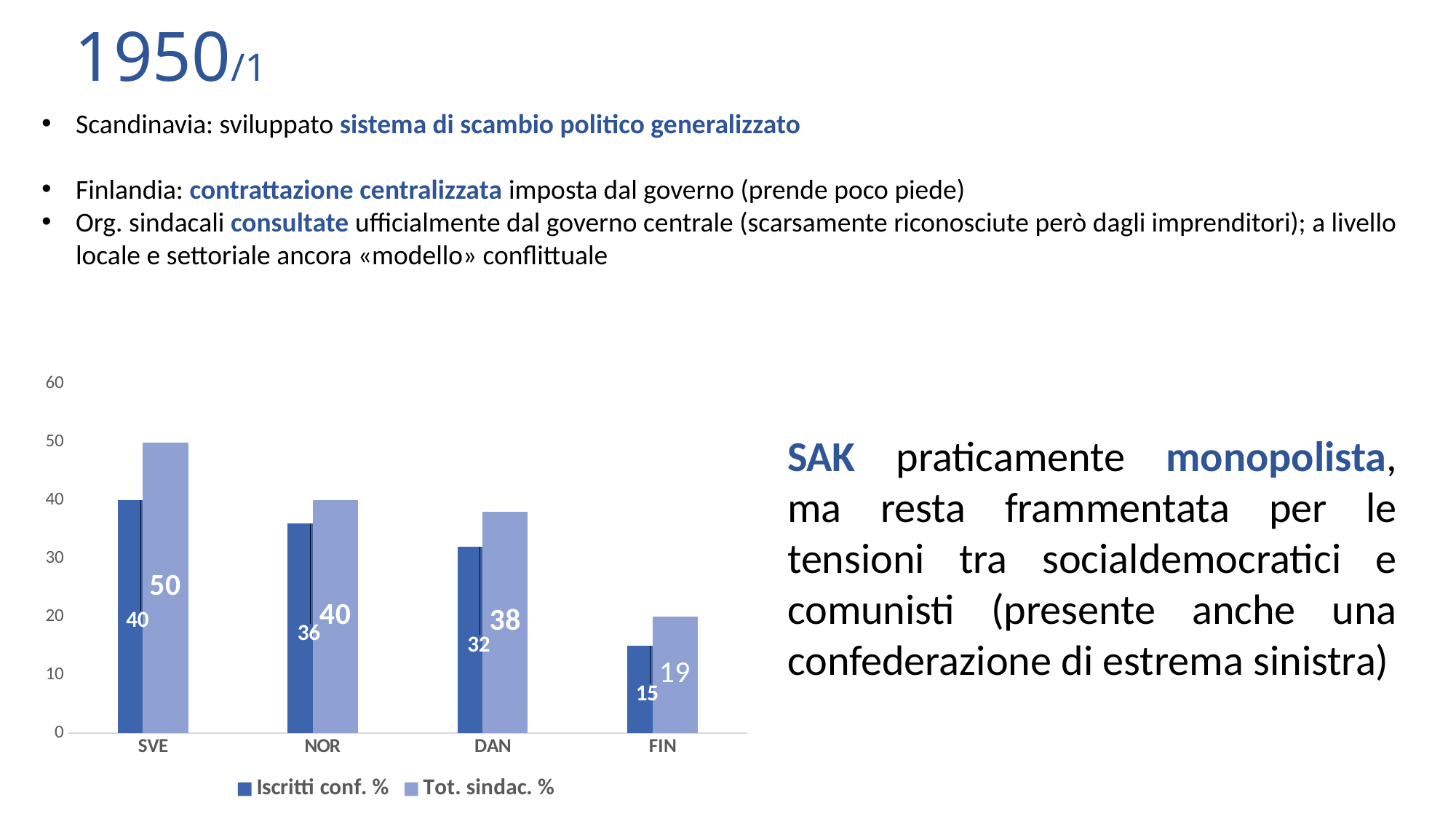
Which category has the lowest Iscritti conf. % value? FIN Which category has the highest Tot. sindac. % value? SVE What is the value of Tot. sindac. % for NOR? 40 How many series does the chart legend list? 2 What is the value of Tot. sindac. % for DAN? 38 Do the Tot. sindac. % values rise or fall from SVE to FIN along the x axis? fall What is the value of Iscritti conf. % for FIN? 15 How many categories are shown on the x axis of the chart? 4 What is the difference between Tot. sindac. % and Iscritti conf. % for DAN? 6 What is the value of Iscritti conf. % for SVE? 40 What kind of chart is shown on the slide? bar chart Which is larger: Iscritti conf. % for NOR or Iscritti conf. % for DAN? Iscritti conf. % for NOR